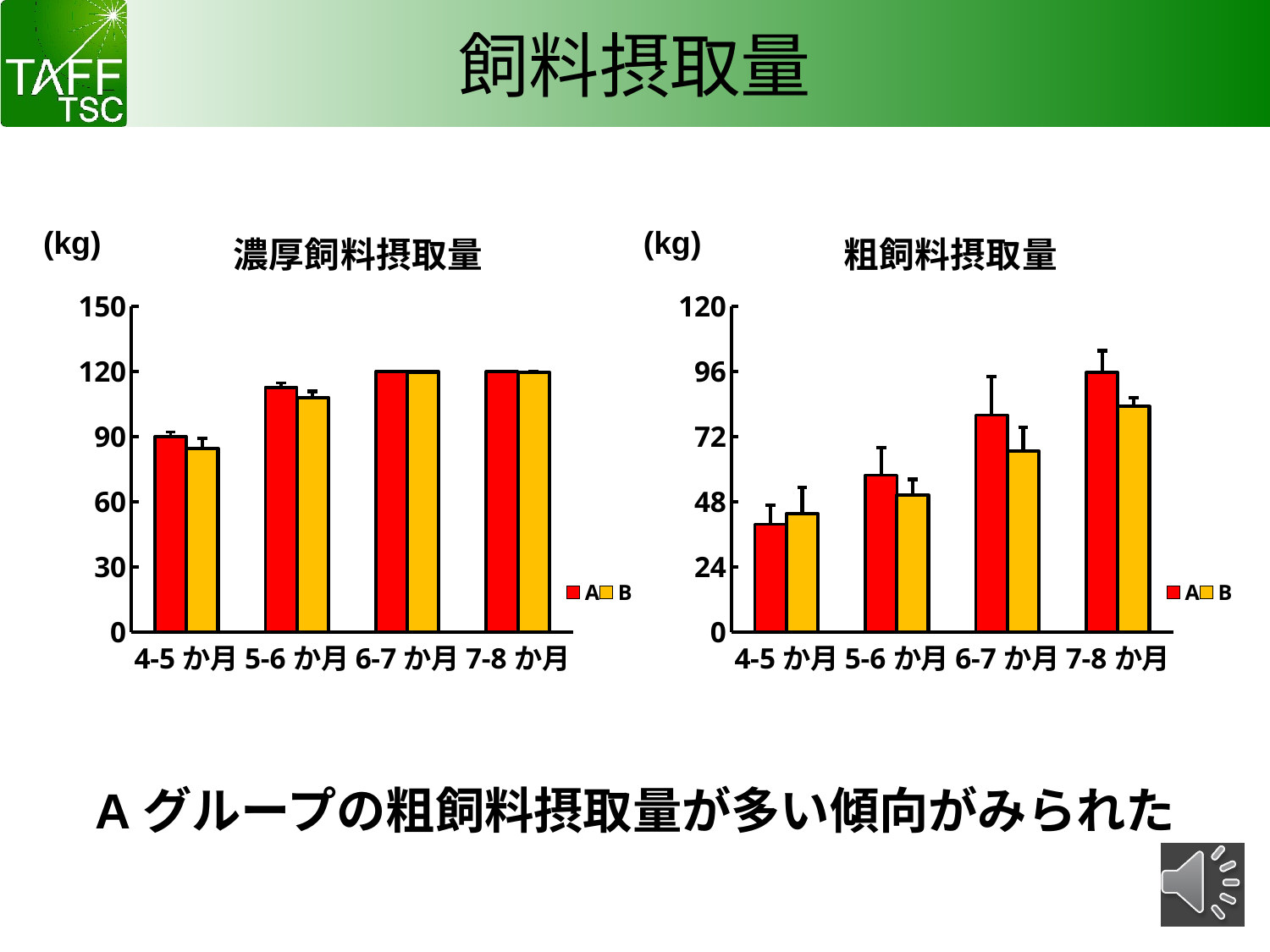
In the 濃厚飼料摂取量 chart, is the value for series B at 4-5 か月 greater or less than 90? less In the 粗飼料摂取量 chart, at which age category is the value for series A highest? 7-8 か月 In the 粗飼料摂取量 chart, do the values for series A rise or fall from 4-5 か月 to 7-8 か月? rise What unit is shown on the y axis of both charts? kg How many series does the legend of the 粗飼料摂取量 chart list? 2 In the 粗飼料摂取量 chart, which series has the larger value at 4-5 か月, A or B? B How many age categories are shown on the x axis of the 濃厚飼料摂取量 chart? 4 In the 粗飼料摂取量 chart, is the value for series A at 4-5 か月 greater or less than 48? less In the 粗飼料摂取量 chart, is the value for series B at 6-7 か月 greater or less than 72? less In the 粗飼料摂取量 chart, at which age category is the value for series A lowest? 4-5 か月 In the 粗飼料摂取量 chart, which series has the larger value at 7-8 か月, A or B? A What kind of chart is the 濃厚飼料摂取量 chart on the left? bar chart